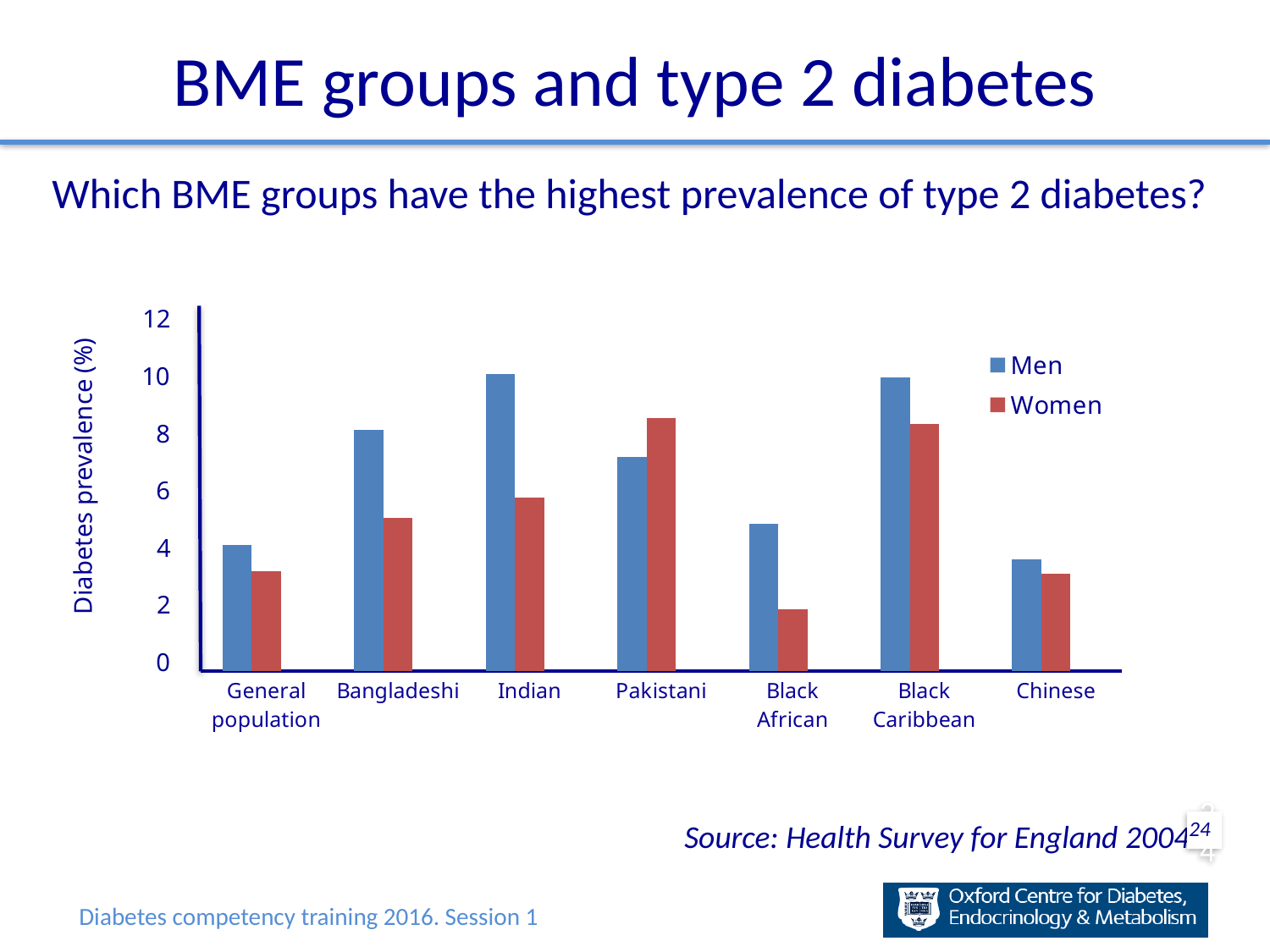
How many series does the legend list? 2 Is the Men value for Indian greater or less than 8? greater Is the Women value for General population greater or less than 4? less Which group has the lowest diabetes prevalence for Men? Chinese Is the Women value for Black African greater or less than 4? less For Bangladeshi, which is larger: the Men value or the Women value? Men Which group has the lowest diabetes prevalence for Women? Black African What is the title of the vertical axis? Diabetes prevalence (%) What kind of chart is shown on the slide? bar chart For Pakistani, which is larger: the Men value or the Women value? Women How many groups are shown along the x axis? 7